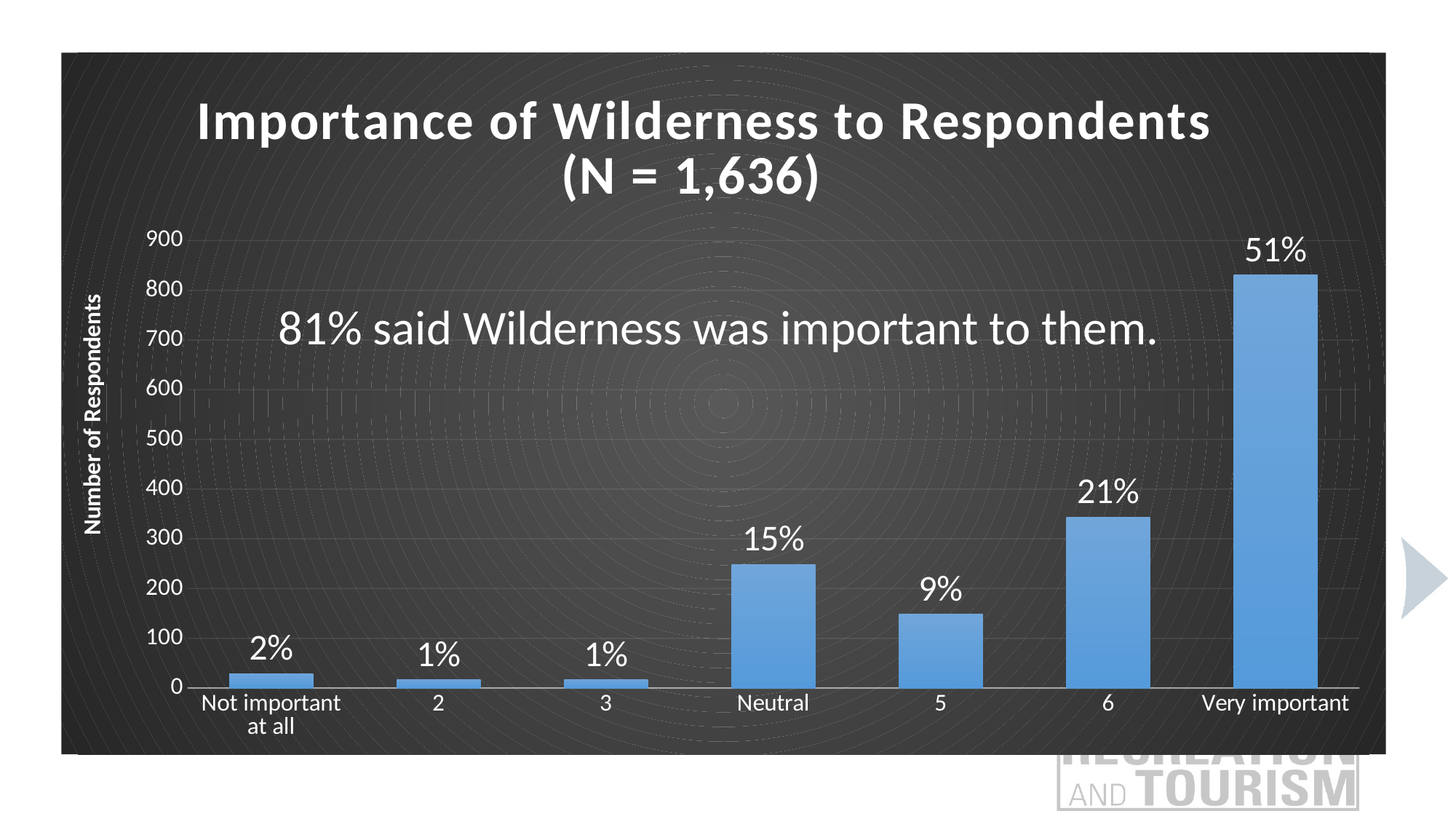
What percentage label is shown on the bar for category "6"? 21% What is the difference in percentage points between the labels for "Very important" and "6"? 30% Is the number of respondents for "Very important" greater or less than 800? greater What percentage label is shown on the bar for "Very important"? 51% Which has the larger value, "Neutral" or "5"? Neutral Is the number of respondents for "Neutral" greater or less than 300? less What is the title of the y axis? Number of Respondents What percentage label is shown on the bar for "Not important at all"? 2% What percentage label is shown on the bar for "Neutral"? 15% What kind of chart is shown on the slide? Bar chart Which category has the highest bar? Very important How many categories are shown on the x axis? 7